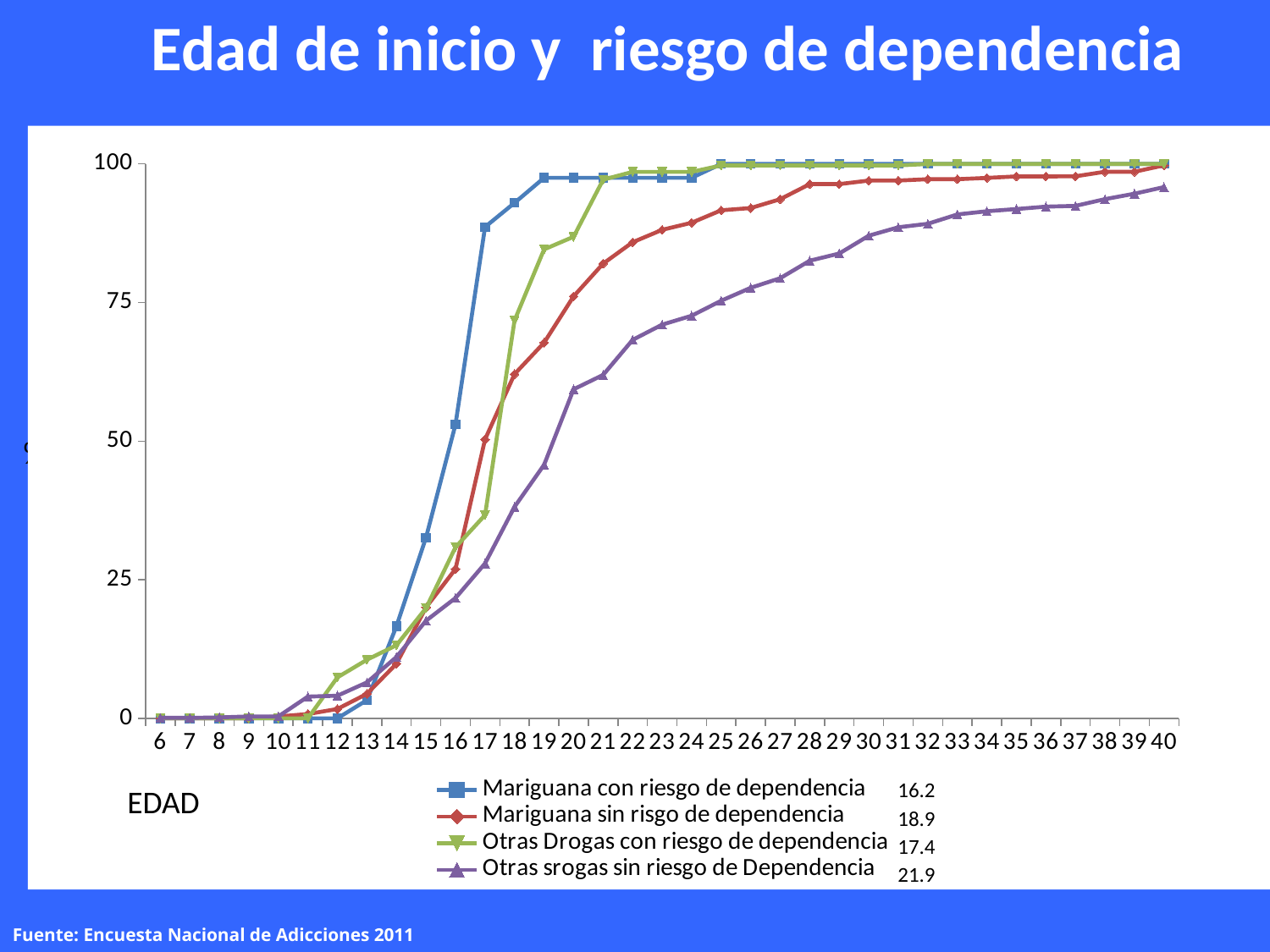
Is the value for 'Otras srogas sin riesgo de Dependencia' at age 20 greater or less than 50? greater Which series has the lowest value at age 30? Otras srogas sin riesgo de Dependencia How many series does the legend list? 4 Is the value for 'Otras Drogas con riesgo de dependencia' at age 19 greater or less than 75? greater What kind of chart is shown on the slide? line chart Is the value for 'Mariguana sin risgo de dependencia' at age 19 greater or less than 75? less What is the title of the chart? Edad de inicio y riesgo de dependencia How many age values are shown along the x axis? 35 Do the values of 'Mariguana sin risgo de dependencia' rise or fall as age increases along the x axis? rise At age 20, which is larger: 'Mariguana con riesgo de dependencia' or 'Otras srogas sin riesgo de Dependencia'? Mariguana con riesgo de dependencia What number is printed next to the legend entry 'Mariguana con riesgo de dependencia'? 16.2